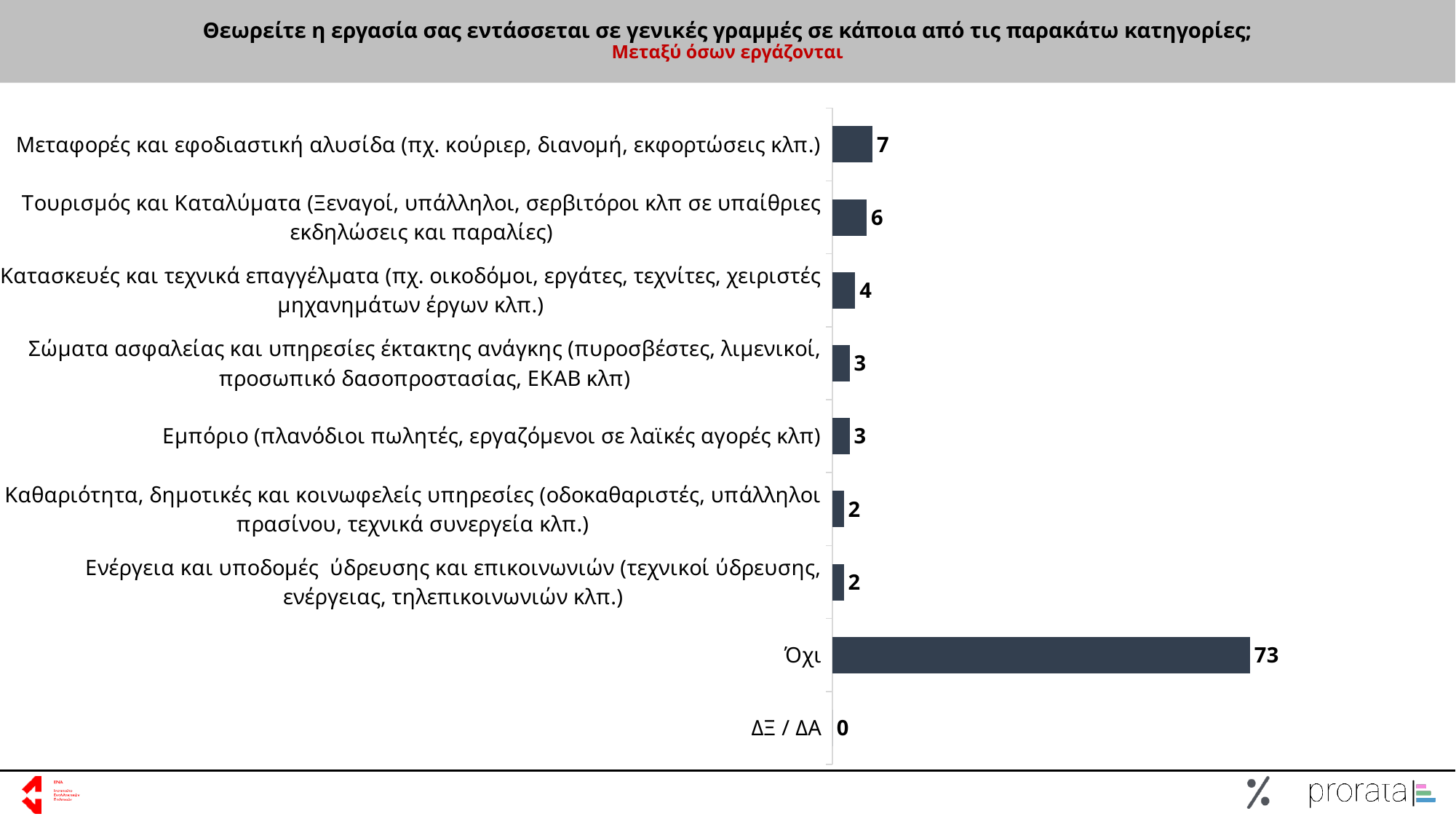
Which is larger, the value for Τουρισμός και Καταλύματα or the value for Κατασκευές και τεχνικά επαγγέλματα? Τουρισμός και Καταλύματα What is the red subtitle text under the chart title? Μεταξύ όσων εργάζονται What kind of chart is shown on the slide? Bar chart What is the difference between the values for Όχι and Μεταφορές και εφοδιαστική αλυσίδα? 66 What is the value for Κατασκευές και τεχνικά επαγγέλματα? 4 What is the value for Μεταφορές και εφοδιαστική αλυσίδα? 7 What is the value for ΔΞ / ΔΑ? 0 How many categories are shown in the chart? 9 What is the value for Τουρισμός και Καταλύματα? 6 Which category has the highest value? Όχι Which category has the lowest value? ΔΞ / ΔΑ What is the value for Όχι? 73